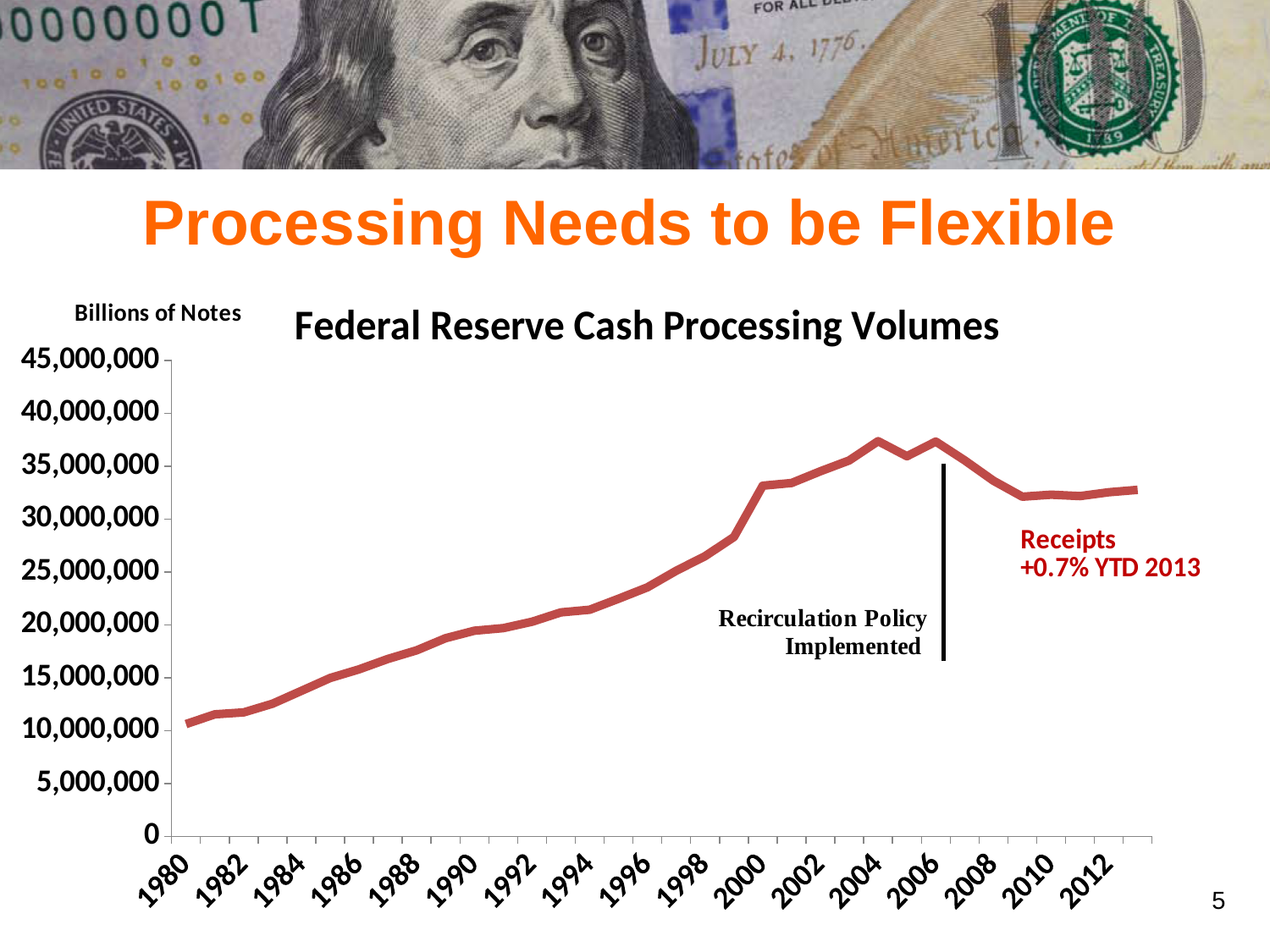
How many year labels are shown on the x axis? 17 Do the processing volumes rise or fall from 1980 to 2004? rise Is the value for 2012 greater or less than 35,000,000? less Is the value for 1996 greater or less than 20,000,000? greater Is the value for 2004 greater or less than 35,000,000? greater Which year has the larger processing volume, 1990 or 2000? 2000 Which year on the x axis has the lowest processing volume? 1980 What is the title of the chart? Federal Reserve Cash Processing Volumes What unit label is shown above the vertical axis of the chart? Billions of Notes What kind of chart is shown on the slide? line chart